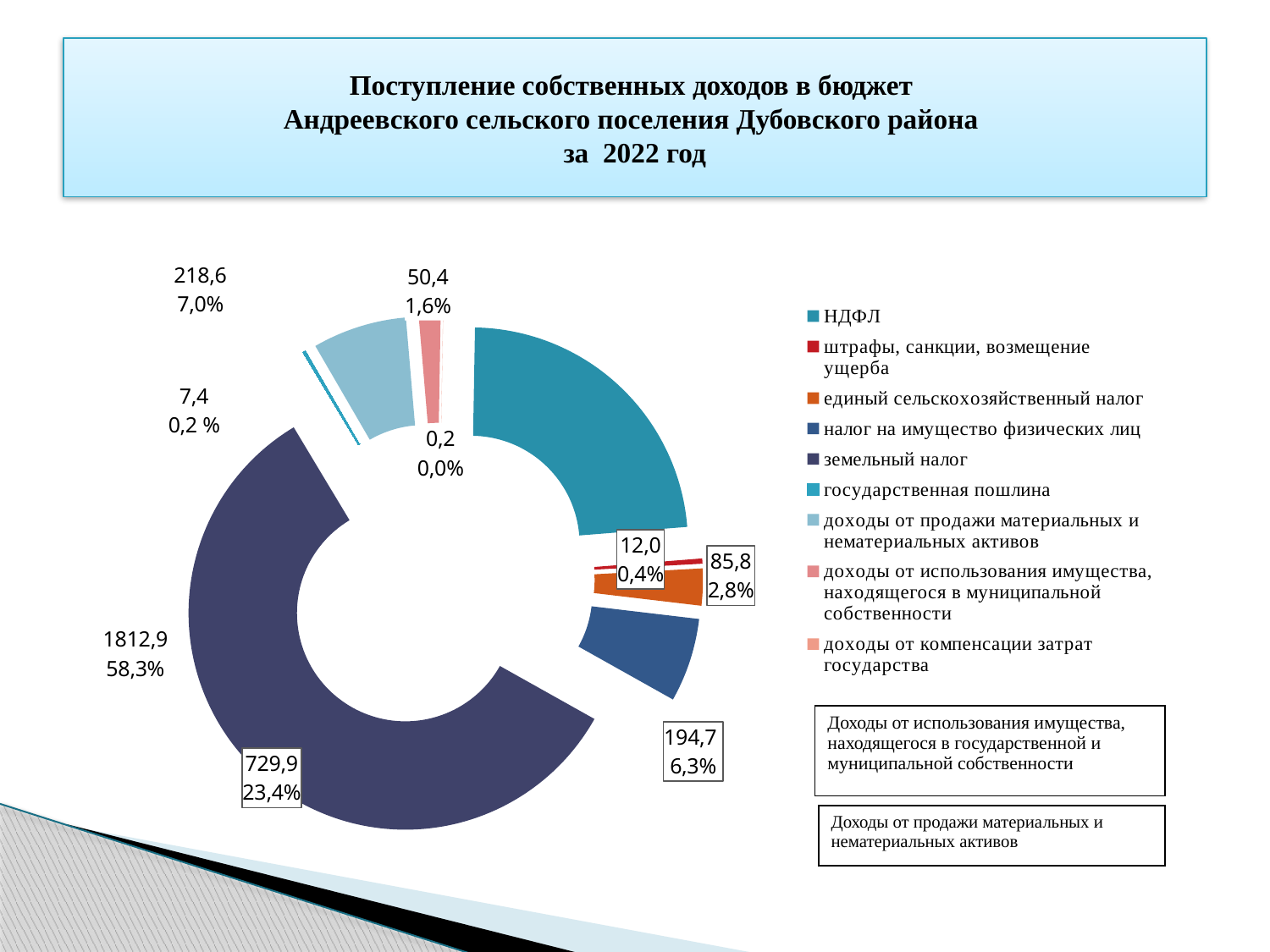
What share of the total does земельный налог account for? 58,3% What is the value shown for налог на имущество физических лиц? 194,7 What share does государственная пошлина have in the chart? 0,2 % Which is larger: налог на имущество физических лиц or единый сельскохозяйственный налог? налог на имущество физических лиц What is the value shown for единый сельскохозяйственный налог? 85,8 Which category has the largest share of the chart? земельный налог How many categories does the legend of the chart list? 9 What is the value shown for земельный налог? 1812,9 For which year does the slide title say the revenue data is shown? 2022 What is the difference between the values for земельный налог and НДФЛ? 1083,0 Which category has the smallest value in the chart? доходы от компенсации затрат государства What kind of chart is shown on the slide? Doughnut (pie) chart